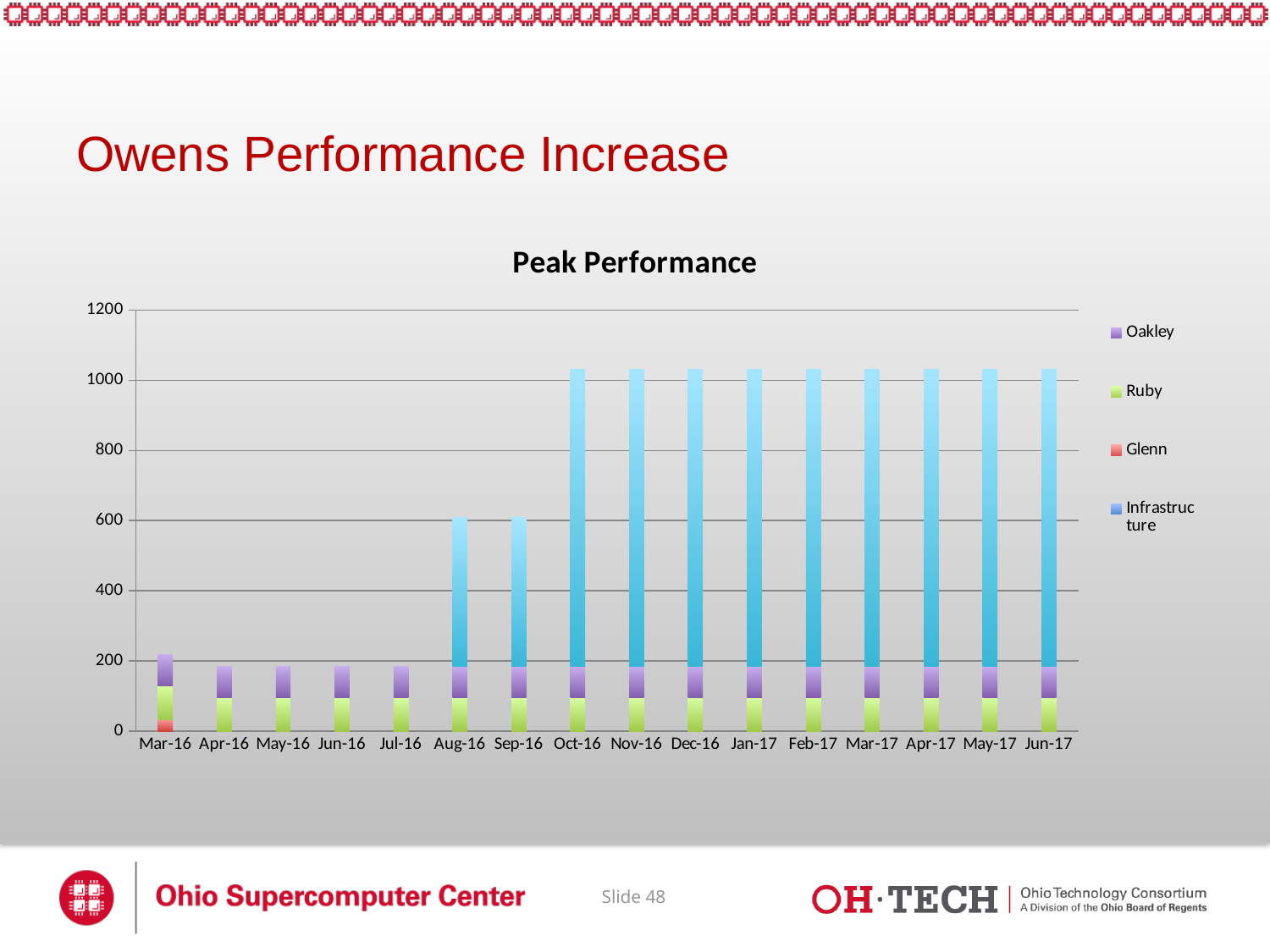
Is the total for Apr-16 greater or less than 400? less Is the total for Aug-16 greater or less than 400? greater What is the title of the chart? Peak Performance Is the total for Jun-17 greater or less than 800? greater How many months are shown along the x axis? 16 How many series does the legend list? 4 Do the total bar heights generally rise or fall from Mar-16 to Jun-17? Rise What kind of chart is shown on the slide? Stacked bar chart Which has the larger total, Oct-16 or Aug-16? Oct-16 Which series appears only in the Mar-16 bar? Glenn Which has the larger total, Aug-16 or Apr-16? Aug-16